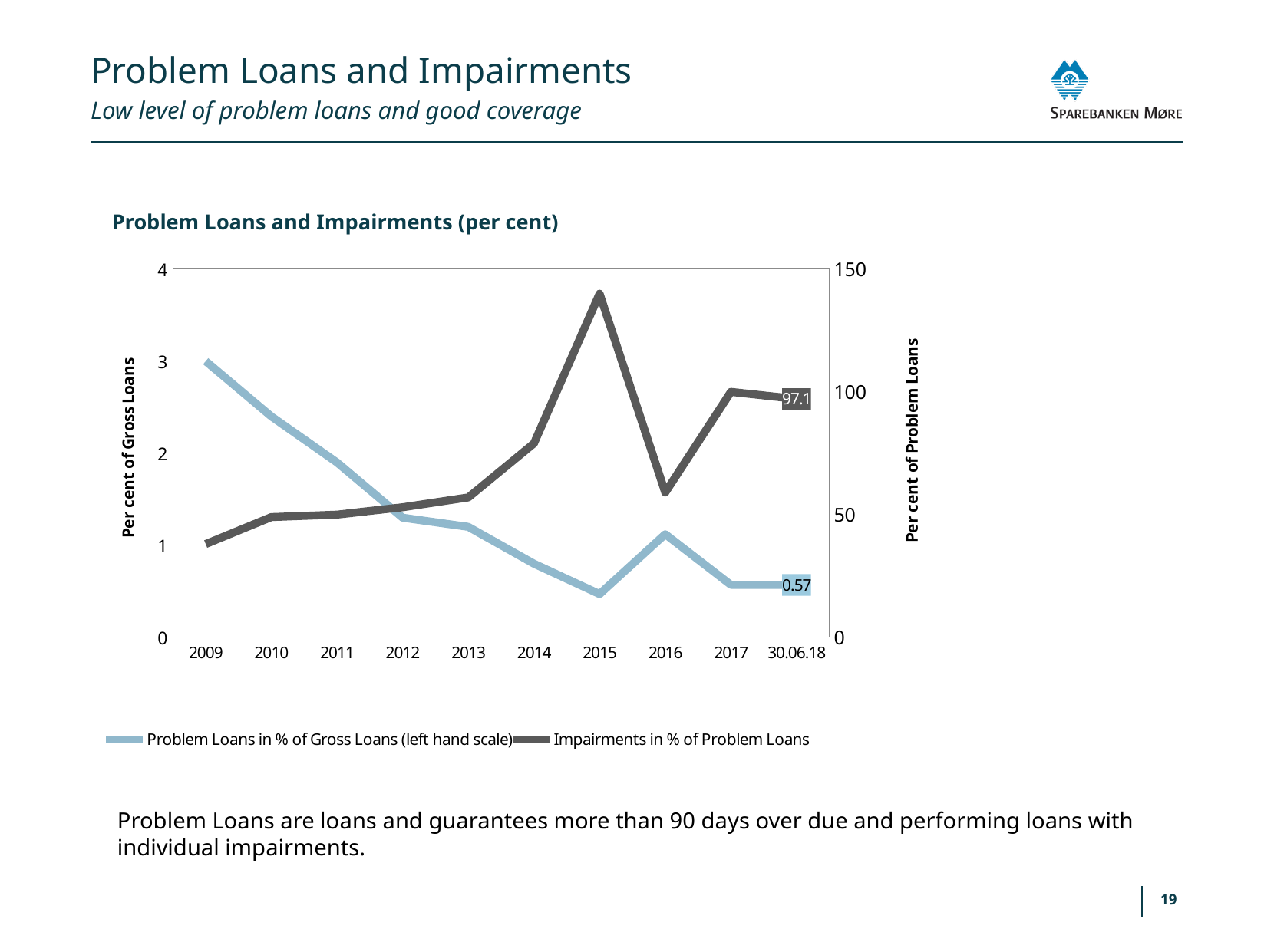
In which year is Problem Loans in % of Gross Loans highest? 2009 In which year is Impairments in % of Problem Loans highest? 2015 Does Problem Loans in % of Gross Loans rise or fall from 2009 to 2012? fall How many points are plotted along the x axis for each series? 10 What is the value of Problem Loans in % of Gross Loans at 30.06.18? 0.57 In which year is Impairments in % of Problem Loans lowest? 2009 What is the label of the right-hand vertical axis? Per cent of Problem Loans Is the value for Impairments in % of Problem Loans in 2016 greater or less than 100? less What is the value of Impairments in % of Problem Loans at 30.06.18? 97.1 How many series does the legend list? 2 Is the value for Problem Loans in % of Gross Loans in 2009 greater or less than 2? greater What kind of chart is shown on the slide? Line chart